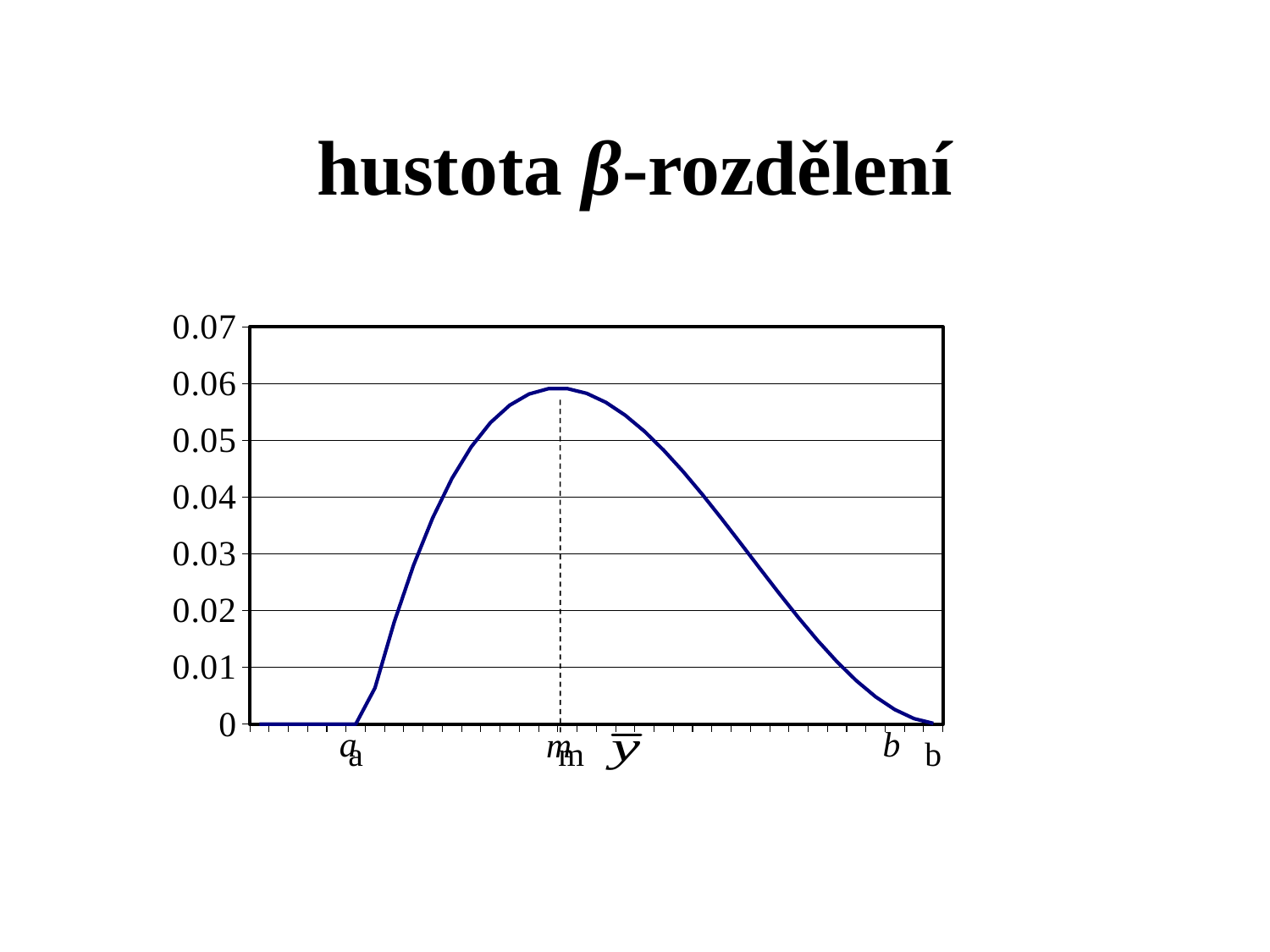
What is the title of the chart on the slide? hustota β-rozdělení Is the peak value of the curve at m greater or less than 0.05? greater What is the highest tick value shown on the y axis? 0.07 Does the curve rise or fall between a and m? rises What is the value of the curve at the point labelled b? 0 How many labelled tick values are shown on the y axis? 8 What is the value of the curve at the point labelled a? 0 What kind of chart is shown on the slide? line chart Is the value of the curve at ȳ greater or less than 0.04? greater Does the curve rise or fall between m and b? falls At which labelled point on the x axis does the curve reach its highest value? m Is the value of the curve at m larger than the value at b? yes